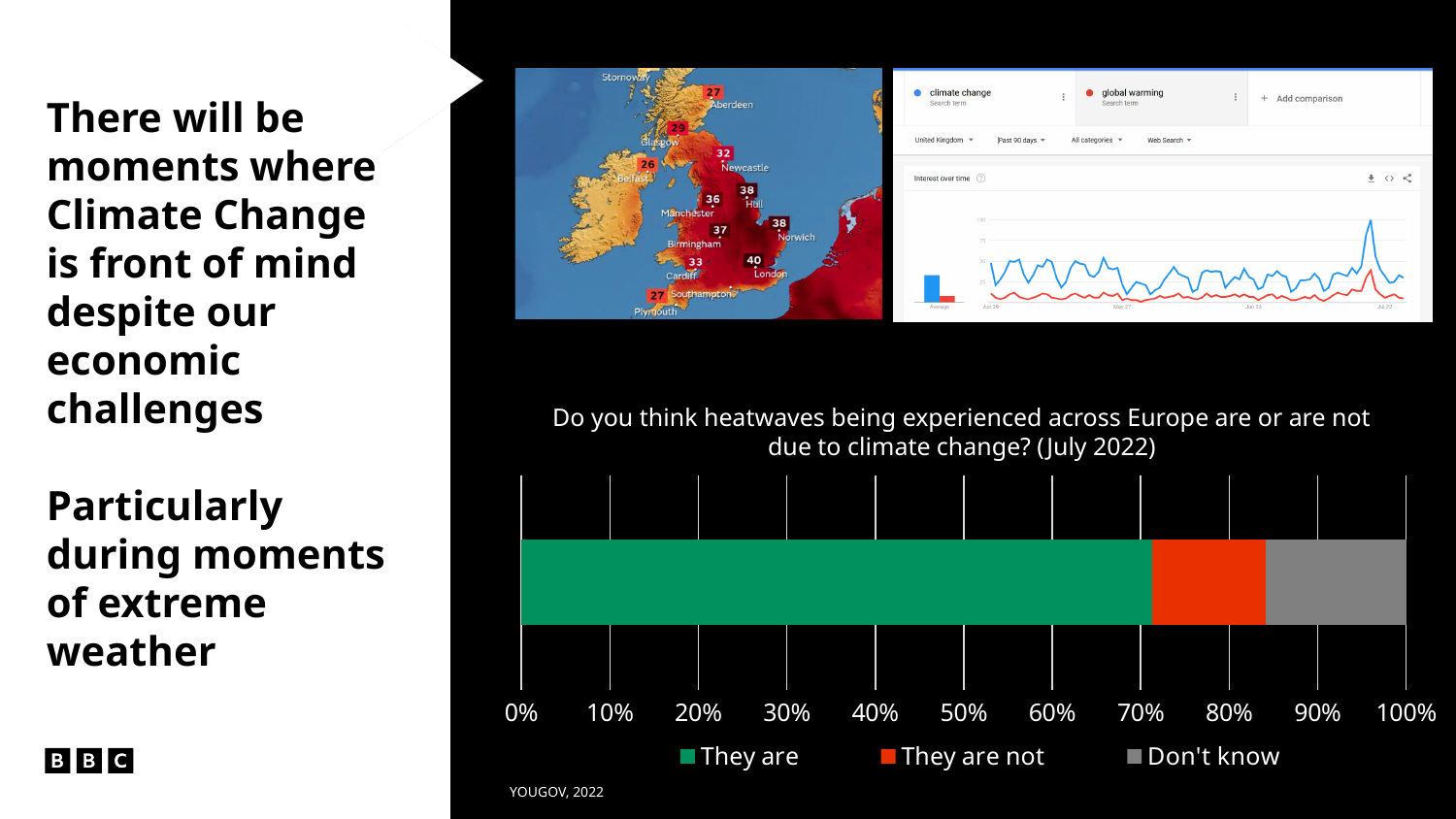
How many series does the legend of the heatwaves chart list? 3 In the heatwaves chart, which response has the largest share? They are In the heatwaves chart, is the share for 'They are not' greater or less than 20%? less What kind of chart is shown under the heatwaves question? bar chart In the heatwaves chart, is the share for 'They are' greater or less than 60%? greater In the Google Trends chart at the top right, how many search terms are compared? 2 What colour represents 'They are not' in the heatwaves chart? orange In the Google Trends chart at the top right, which search term shows higher interest over time? climate change What is the source cited for the heatwaves chart? YOUGOV, 2022 In the heatwaves chart, which is larger: the share for 'They are' or the share for 'Don't know'? They are In the heatwaves chart, is the share for 'Don't know' greater or less than 10%? greater